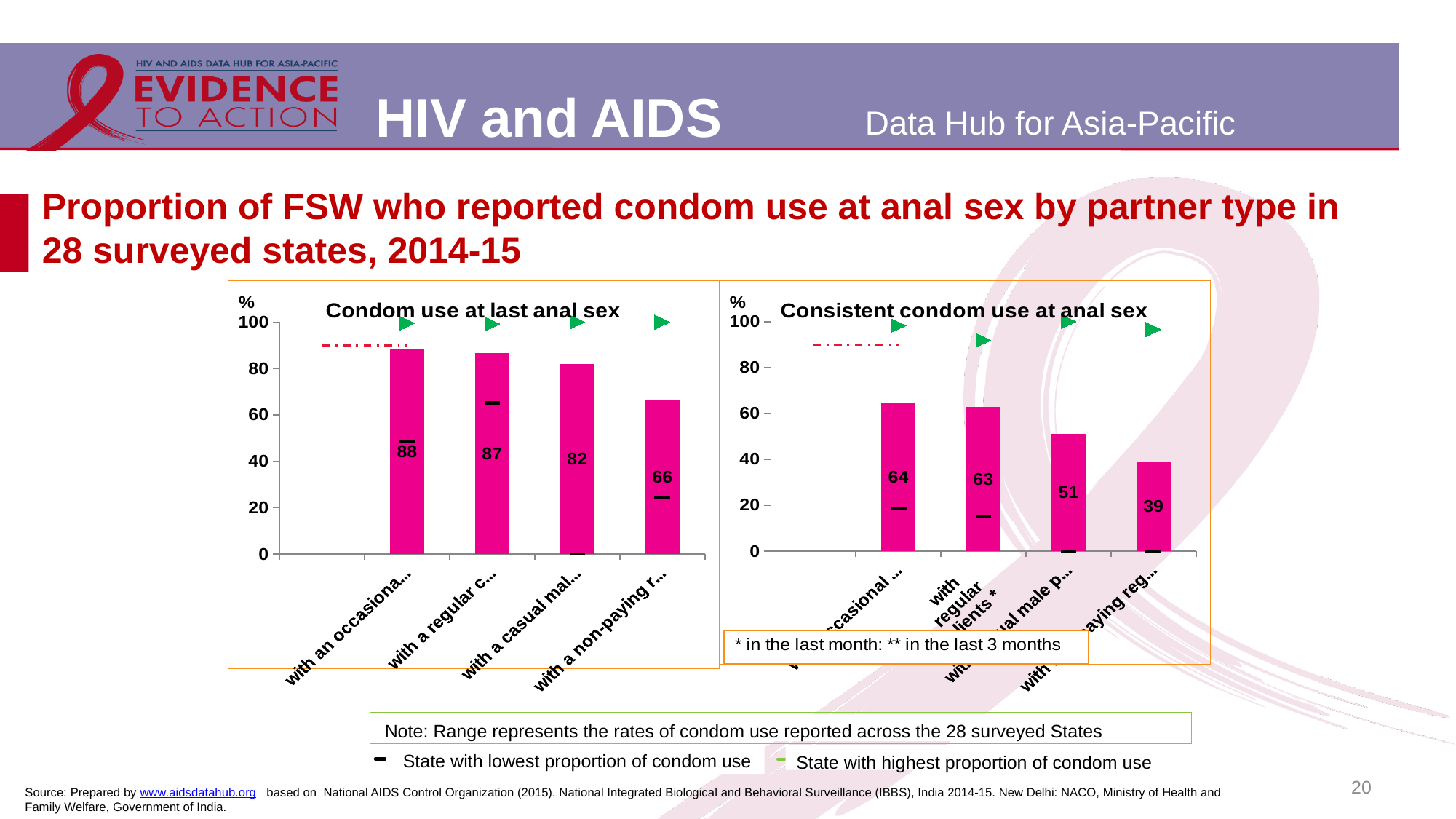
In the 'Consistent condom use at anal sex' chart, which bar has the highest value? with an occasional ... (first bar), 64 In the 'Condom use at last anal sex' chart, what is the value of the first bar (with an occasional...)? 88 Which is larger: the third bar in the 'Condom use at last anal sex' chart or the third bar in the 'Consistent condom use at anal sex' chart? Condom use at last anal sex (82) In the 'Consistent condom use at anal sex' chart, what is the difference between the first bar (64) and the fourth bar (39)? 25 In the 'Condom use at last anal sex' chart, which bar has the lowest value? with a non-paying r... (fourth bar), 66 In the 'Consistent condom use at anal sex' chart, what is the value of the third bar (with a casual male p...)? 51 In the 'Condom use at last anal sex' chart, what is the difference between the first bar (88) and the fourth bar (66)? 22 What type of chart is 'Condom use at last anal sex'? Bar chart In the 'Consistent condom use at anal sex' chart, what is the value of the fourth bar (with a non-paying reg...)? 39 How many bars are plotted in the 'Consistent condom use at anal sex' chart? 4 In the 'Consistent condom use at anal sex' chart, do the values rise or fall from left to right? Fall In the 'Condom use at last anal sex' chart, what is the value of the fourth bar (with a non-paying r...)? 66